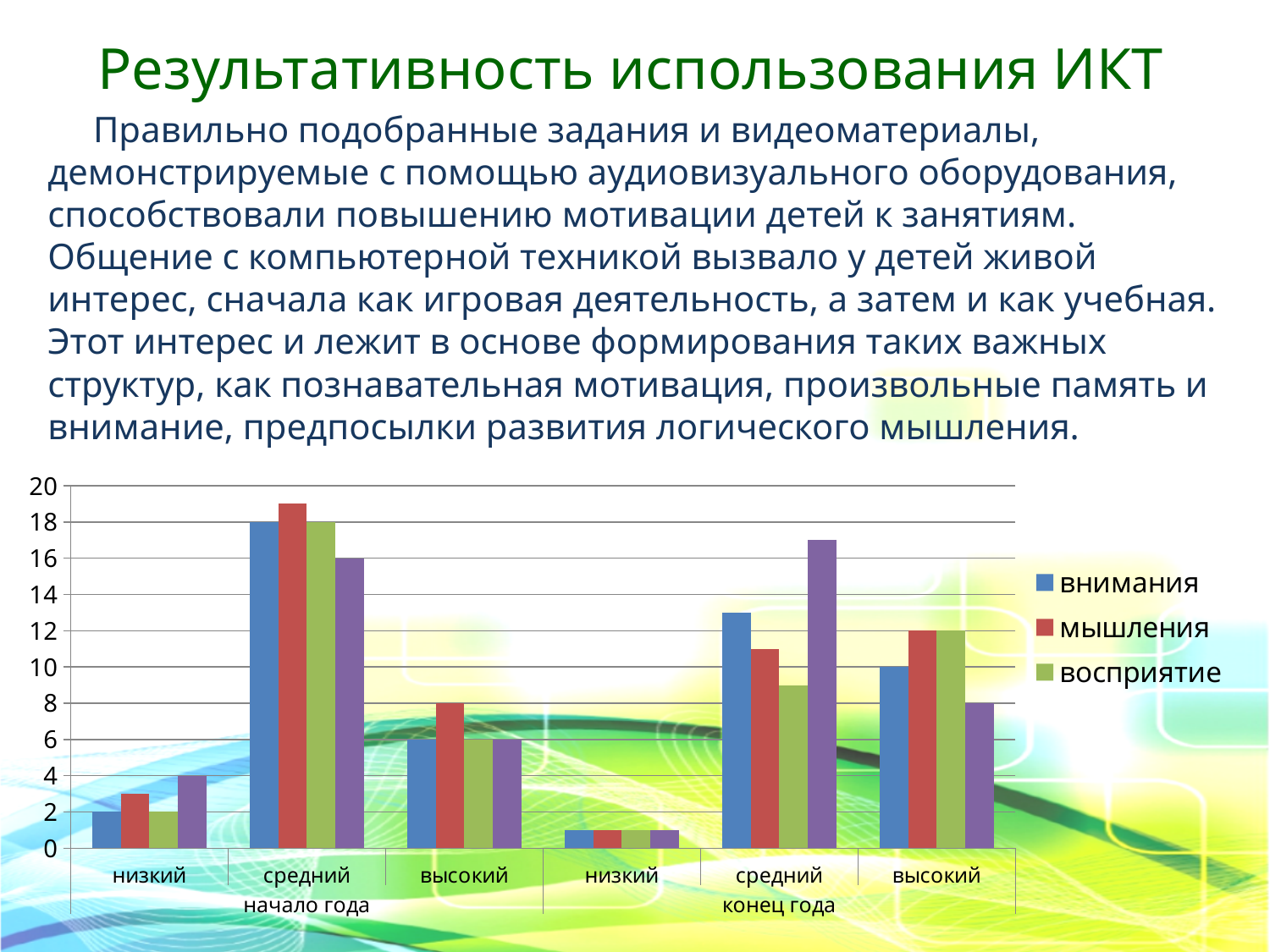
Which category has the lowest value for внимания? низкий (конец года) Which is larger: внимания for средний in начало года or внимания for средний in конец года? внимания for средний in начало года What is the value of внимания for средний in начало года? 18 How many series does the chart legend list? 3 What is the value of восприятие for высокий in конец года? 12 How many categories are shown along the x axis of the chart? 6 Is the value of внимания for средний in конец года greater or less than 12? greater What is the difference between мышления for высокий in конец года and мышления for высокий in начало года? 4 Is the value of мышления for средний in начало года greater or less than 18? greater What is the value of внимания for высокий in конец года? 10 What kind of chart is shown on the slide? bar chart What is the value of мышления for высокий in начало года? 8